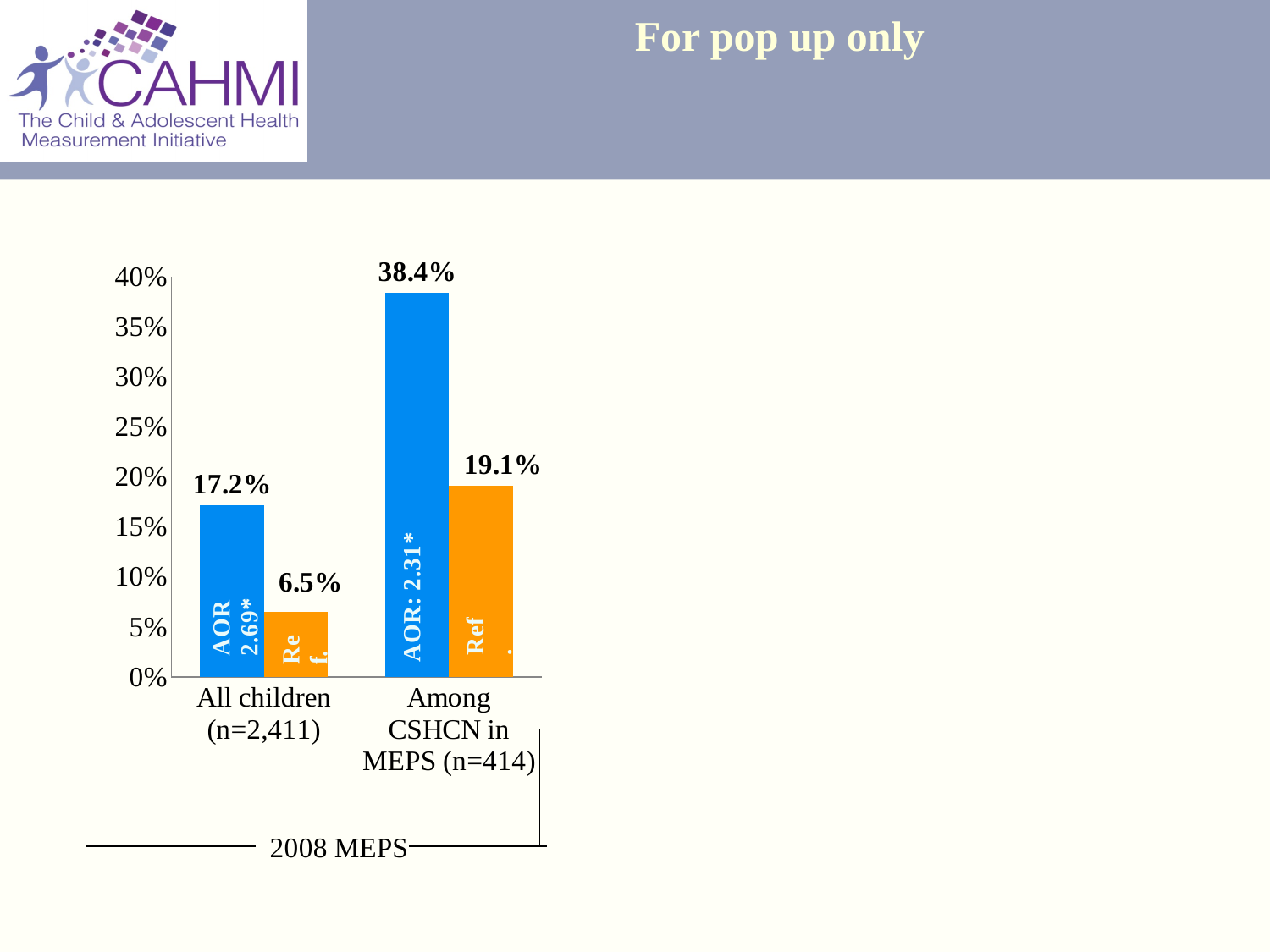
How many categories are shown on the x axis of the chart? 2 Which bar has the highest value in the chart? The blue bar for Among CSHCN in MEPS (n=414), 38.4% What is the value of the orange (Ref.) bar for All children (n=2,411)? 6.5% What is the value of the blue bar for All children (n=2,411)? 17.2% What AOR value is printed on the blue bar for All children (n=2,411)? AOR 2.69* What kind of chart is shown on the slide? bar chart What is the value of the orange (Ref.) bar for Among CSHCN in MEPS (n=414)? 19.1% Which bar has the lowest value in the chart? The orange (Ref.) bar for All children (n=2,411), 6.5% Which is larger: the orange bar for Among CSHCN in MEPS (n=414) or the blue bar for All children (n=2,411)? The orange bar for Among CSHCN in MEPS (n=414) What is the difference between the blue and orange bars for All children (n=2,411)? 10.7% What is the difference between the blue and orange bars for Among CSHCN in MEPS (n=414)? 19.3% What is the value of the blue bar for Among CSHCN in MEPS (n=414)? 38.4%